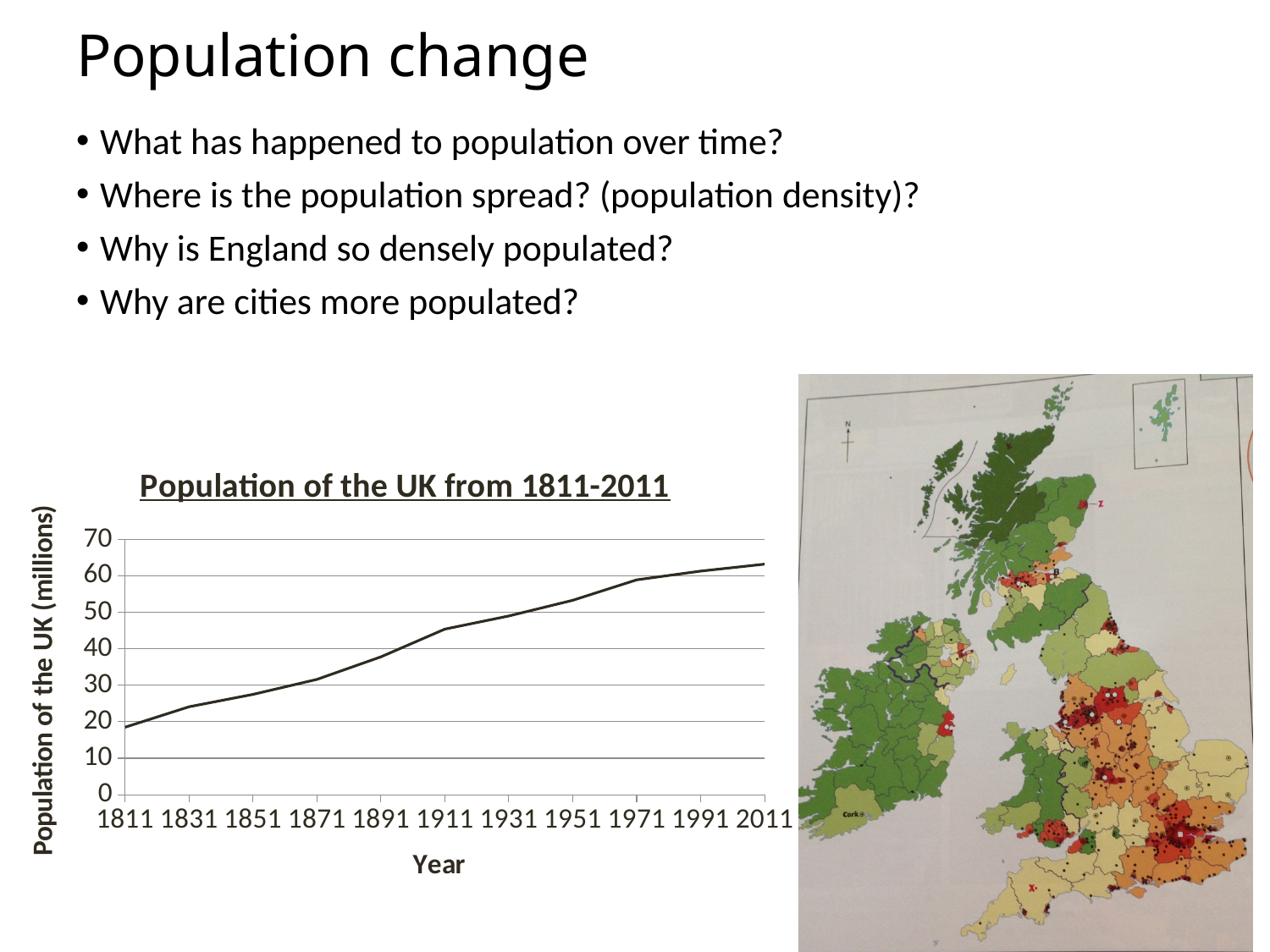
In the chart 'Population of the UK from 1811-2011', is the population in 1971 larger or smaller than in 1891? larger What is the label on the x axis of the chart 'Population of the UK from 1811-2011'? Year In the chart 'Population of the UK from 1811-2011', is the value for 2011 greater or less than 60? greater What type of chart is 'Population of the UK from 1811-2011'? line chart In the chart 'Population of the UK from 1811-2011', is the value for 1951 greater or less than 50? greater How many years are marked on the x axis of the chart 'Population of the UK from 1811-2011'? 11 In the chart 'Population of the UK from 1811-2011', is the value for 1911 greater or less than 40? greater In the chart 'Population of the UK from 1811-2011', which year has the lowest population? 1811 In the chart 'Population of the UK from 1811-2011', which year has the highest population? 2011 What is the label on the y axis of the chart 'Population of the UK from 1811-2011'? Population of the UK (millions) In the chart 'Population of the UK from 1811-2011', does the population rise or fall from 1811 to 2011? rise